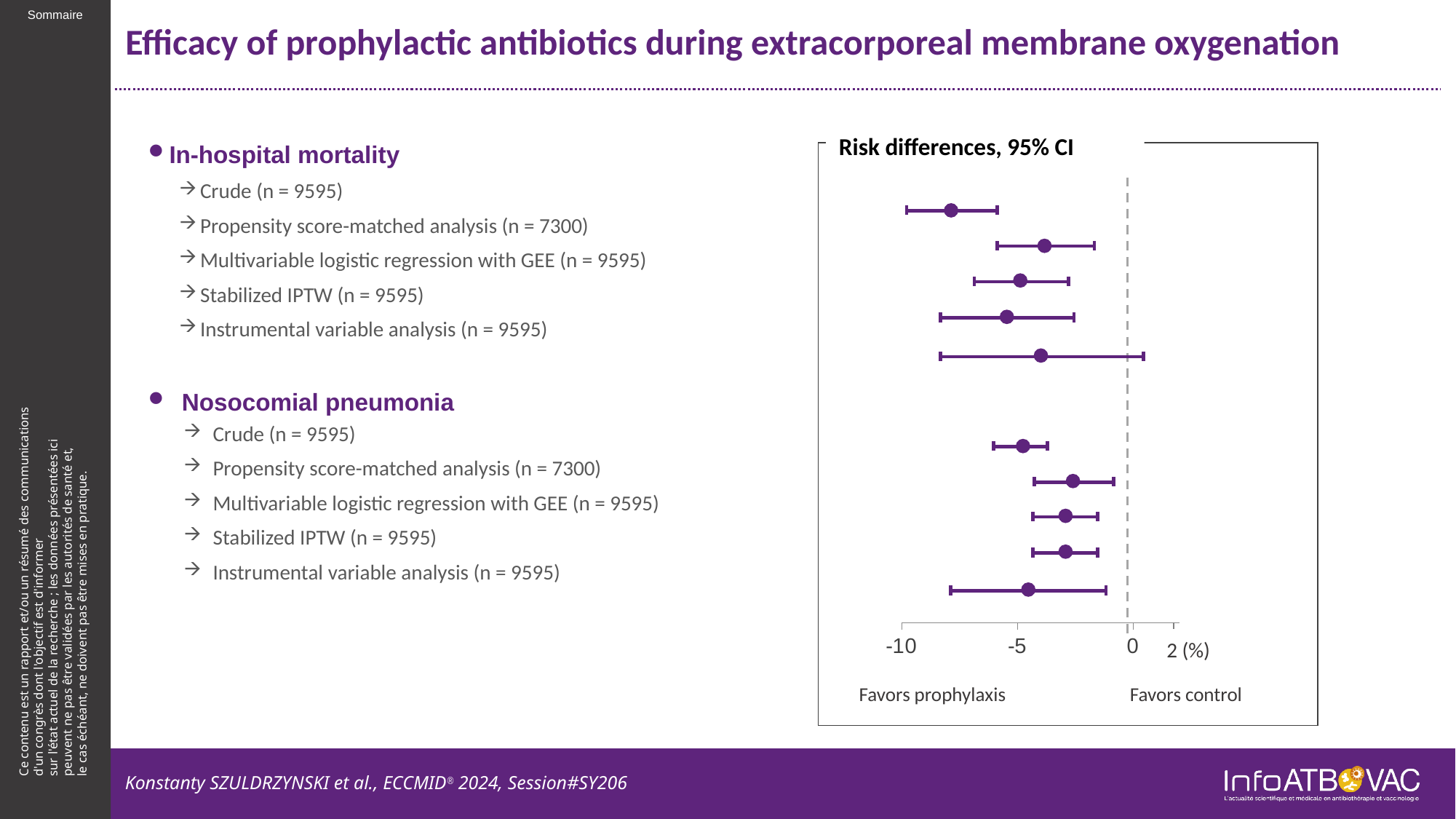
Is the risk difference for the crude analysis of in-hospital mortality greater or less than -5? less What labels appear below the x axis on the left and right sides of the chart? Favors prophylaxis (left) and Favors control (right) How many point estimates (rows) are plotted in the chart? 10 Is the risk difference for the stabilized IPTW analysis of nosocomial pneumonia greater or less than -5? greater Is the risk difference for the propensity score-matched analysis of in-hospital mortality greater or less than -5? greater Which analysis has the lowest (most negative) point estimate in the chart? Crude analysis of in-hospital mortality What is the title of the chart? Risk differences, 95% CI Which has the larger risk difference: the crude analysis of in-hospital mortality or the propensity score-matched analysis of in-hospital mortality? Propensity score-matched analysis Which has the larger risk difference: the crude analysis of nosocomial pneumonia or the propensity score-matched analysis of nosocomial pneumonia? Propensity score-matched analysis What kind of chart is shown on the slide? Forest plot (point estimates with 95% confidence interval error bars)